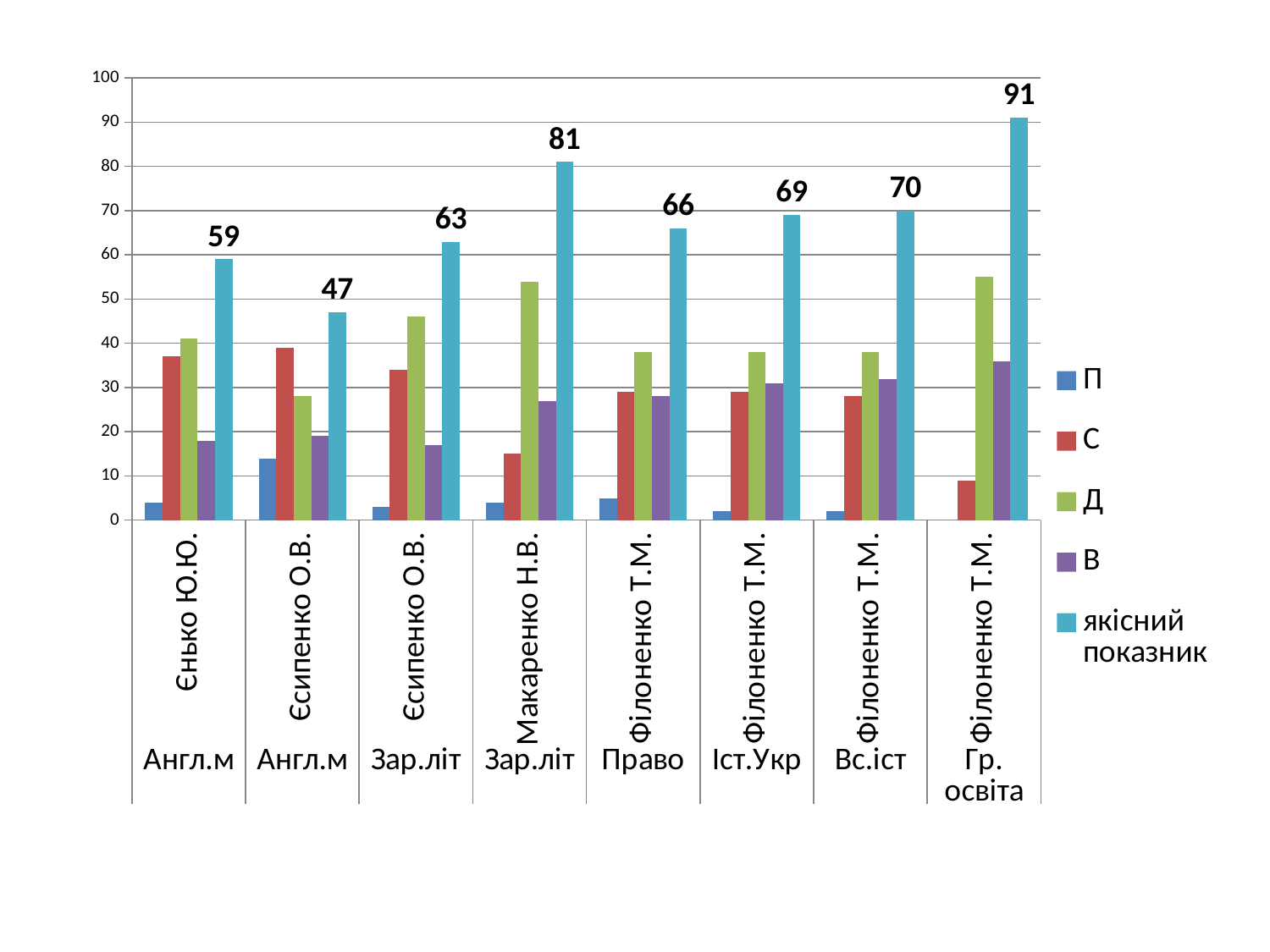
What kind of chart is shown on the slide? bar chart Which has a larger якісний показник value: Філоненко Т.М. (Право) or Філоненко Т.М. (Іст.Укр)? Філоненко Т.М. (Іст.Укр) What is the difference between the якісний показник values for Філоненко Т.М. (Вс.іст) and Філоненко Т.М. (Право)? 4 What is the difference between the якісний показник values for Філоненко Т.М. (Гр. освіта) and Єсипенко О.В. (Англ.м)? 44 Which category has the lowest якісний показник value? Єсипенко О.В. Англ.м Is the Д value for Філоненко Т.М. (Гр. освіта) greater or less than 50? greater What is the якісний показник value for Єнько Ю.Ю. (Англ.м)? 59 Which category has the highest якісний показник value? Філоненко Т.М. Гр. освіта What is the якісний показник value for Макаренко Н.В. (Зар.літ)? 81 How many series does the legend list? 5 Is the С value for Єсипенко О.В. (Англ.м) greater or less than 30? greater How many categories are shown on the x axis? 8